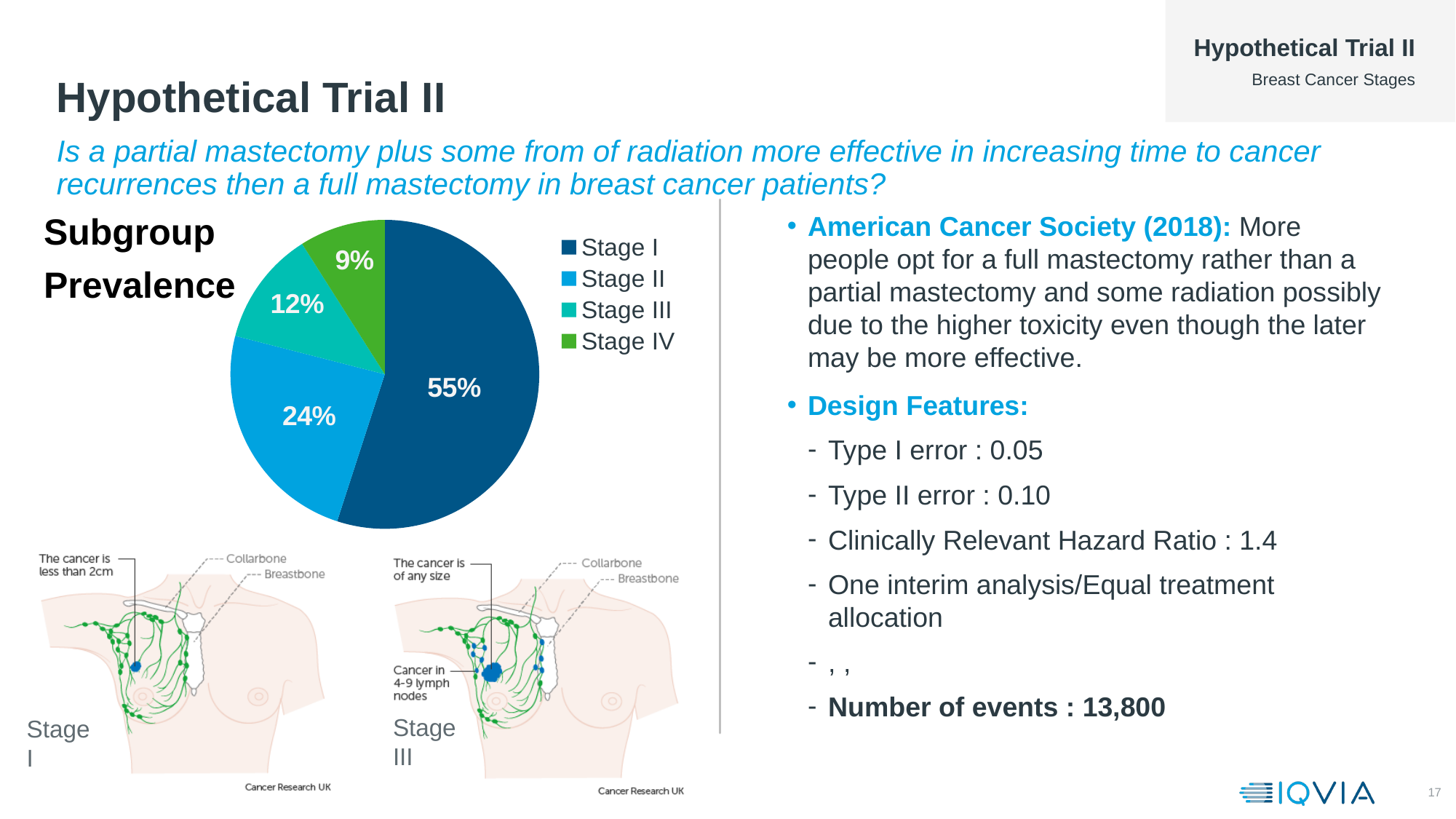
In the Subgroup Prevalence pie chart, what is the difference in percentage points between Stage I and Stage II? 31 What share of the Subgroup Prevalence pie chart is Stage III? 12% How many slices does the Subgroup Prevalence pie chart have? 4 How many entries are listed in the legend of the Subgroup Prevalence pie chart? 4 What colour is the Stage IV slice in the Subgroup Prevalence pie chart? Green Which stage has the smallest slice in the Subgroup Prevalence pie chart? Stage IV In the Subgroup Prevalence pie chart, which is larger: Stage III or Stage IV? Stage III What share of the Subgroup Prevalence pie chart is Stage I? 55% What type of chart is used to show Subgroup Prevalence? Pie chart What share of the Subgroup Prevalence pie chart is Stage II? 24% What share of the Subgroup Prevalence pie chart is Stage IV? 9% Which stage has the largest slice in the Subgroup Prevalence pie chart? Stage I